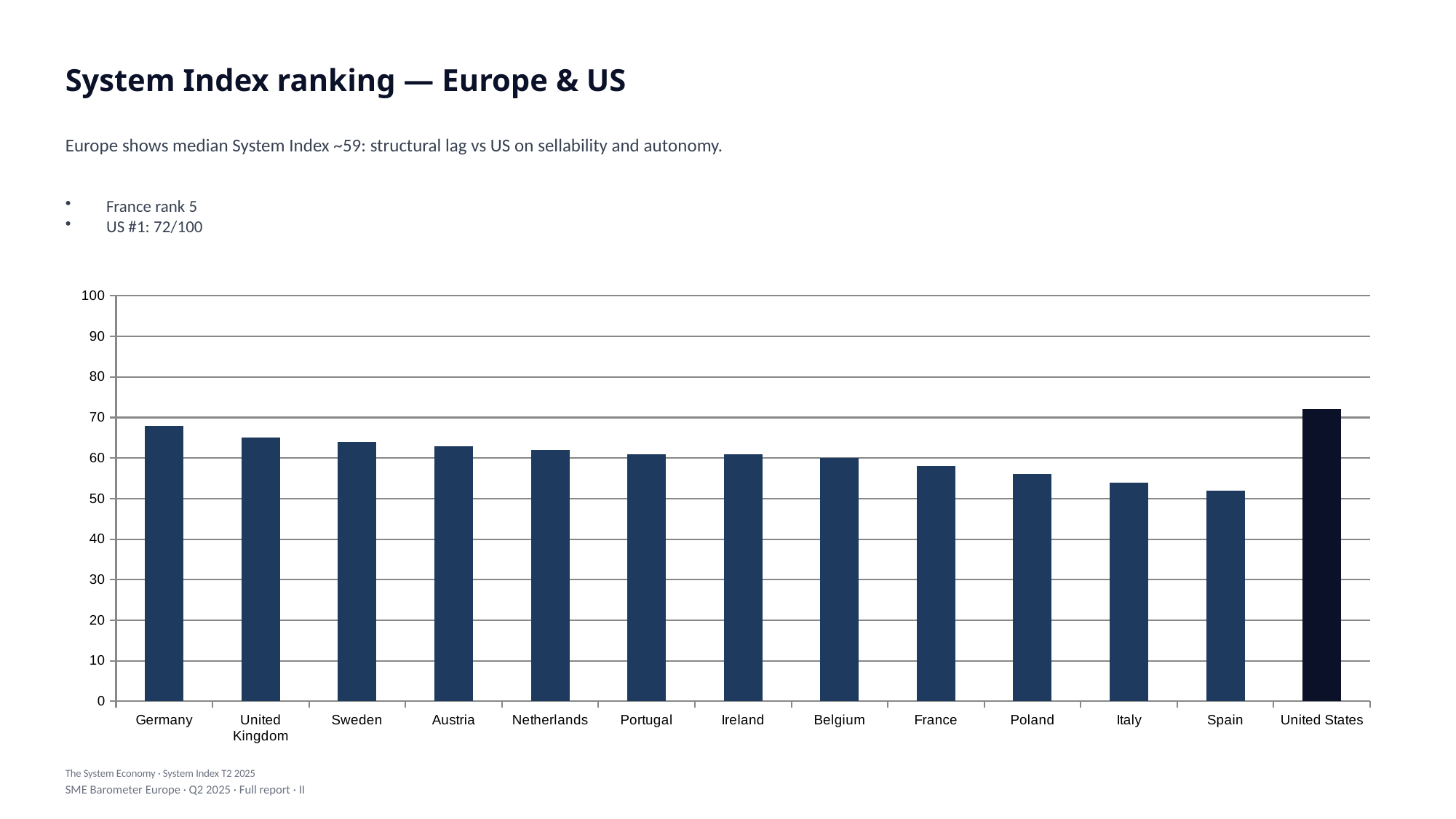
Is the value for Spain greater or less than 60? less What kind of chart is shown on the slide? bar chart Which country has the highest System Index value in the chart? United States Is the value for Italy greater or less than 60? less Is the value for United States greater or less than 70? greater Which country has the lowest System Index value in the chart? Spain What is the title of the slide containing the chart? System Index ranking — Europe & US Which has a higher value, Poland or Italy? Poland Do the values rise or fall from Germany to Spain along the x axis? fall How many countries are shown on the x axis of the chart? 13 Which has a higher value, Germany or United Kingdom? Germany